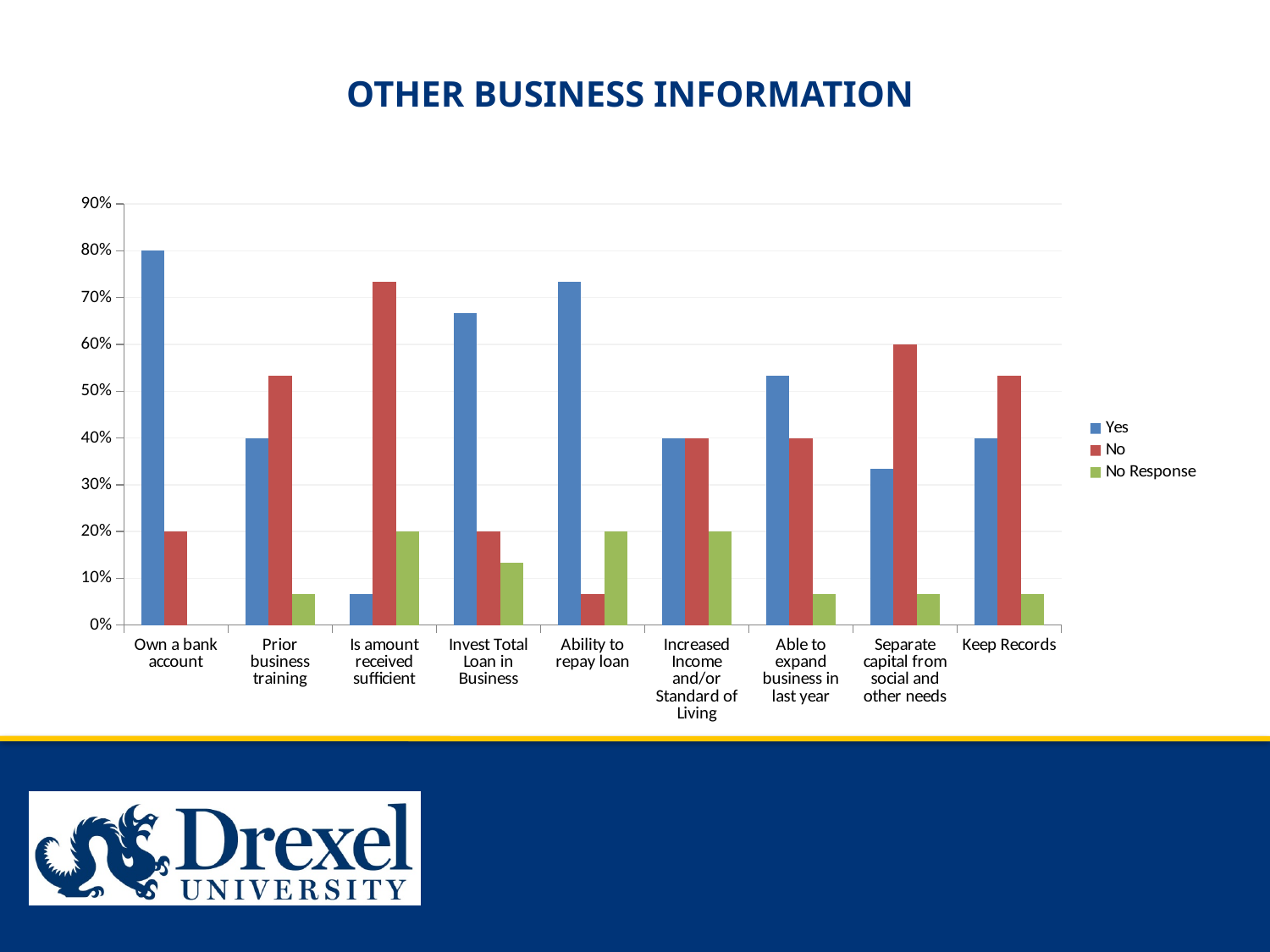
For Separate capital from social and other needs, which is larger, the Yes value or the No value? No Is the No value for Is amount received sufficient greater or less than 70%? greater How many series does the legend list? 3 For Own a bank account, what is the difference between the Yes and No values? 60% How many categories are shown along the x axis? 9 What kind of chart is shown on the slide? bar chart Which category has the highest Yes value? Own a bank account Is the Yes value for Invest Total Loan in Business greater or less than 60%? greater What is the No value for Separate capital from social and other needs? 60% Which category has the lowest Yes value? Is amount received sufficient What is the Yes value for Keep Records? 40% What is the Yes value for Own a bank account? 80%